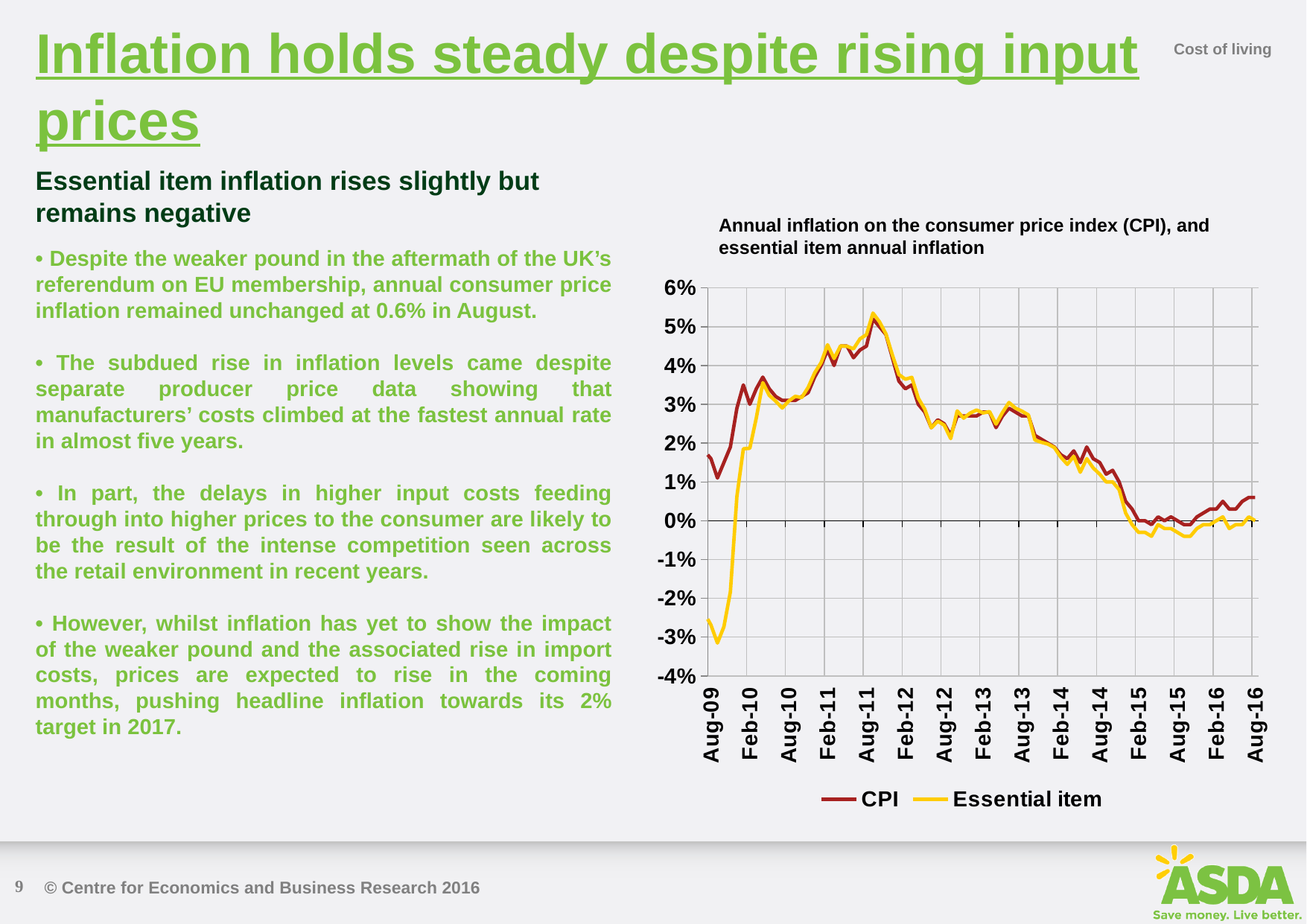
Is the peak Essential item value around Aug-11 greater or less than 5%? greater Is the Essential item value at Aug-09 greater or less than 0%? less What are the two series named in the chart's legend? CPI and Essential item At Aug-09, which series has the higher value, CPI or Essential item? CPI At Feb-10, which series has the higher value, CPI or Essential item? CPI What kind of chart is shown on the slide? Line chart Which series reaches the lowest value shown on the chart? Essential item Does the CPI line generally rise or fall between Aug-11 and Feb-15? Fall Is the CPI value at Aug-16 greater or less than 0%? greater How many series does the chart's legend list? 2 What is the title of the chart? Annual inflation on the consumer price index (CPI), and essential item annual inflation